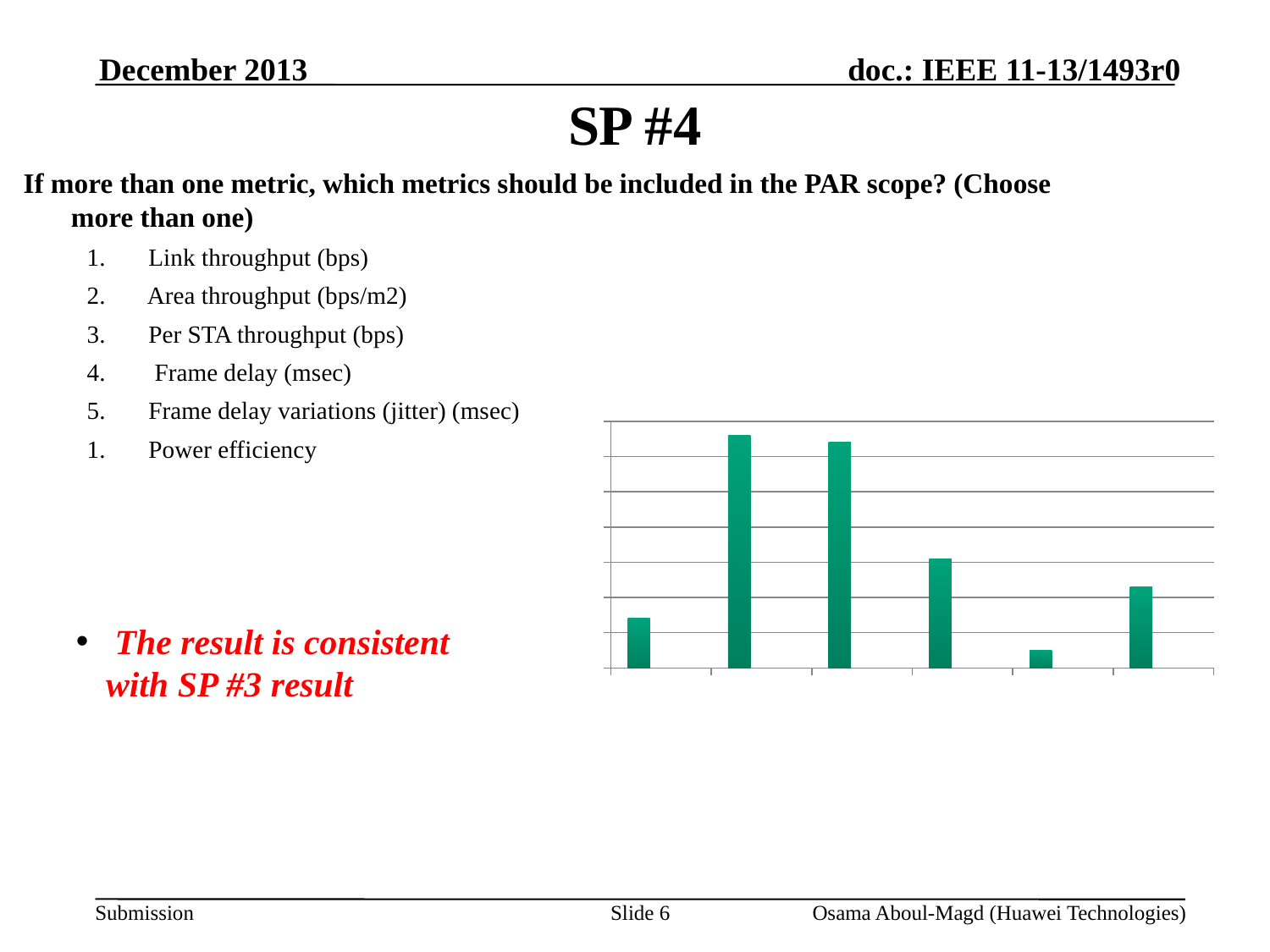
Which bar, counting from the left, is the lowest in the chart? the fifth bar Which is taller in the chart, the third bar from the left or the sixth bar? the third bar Which is taller in the chart, the fourth bar from the left or the sixth bar? the fourth bar Does the chart display a legend? No Which is taller in the chart, the second bar from the left or the fourth bar? the second bar What kind of chart is shown on the slide? bar chart What colour are the bars in the chart? green How many bars are plotted in the chart? 6